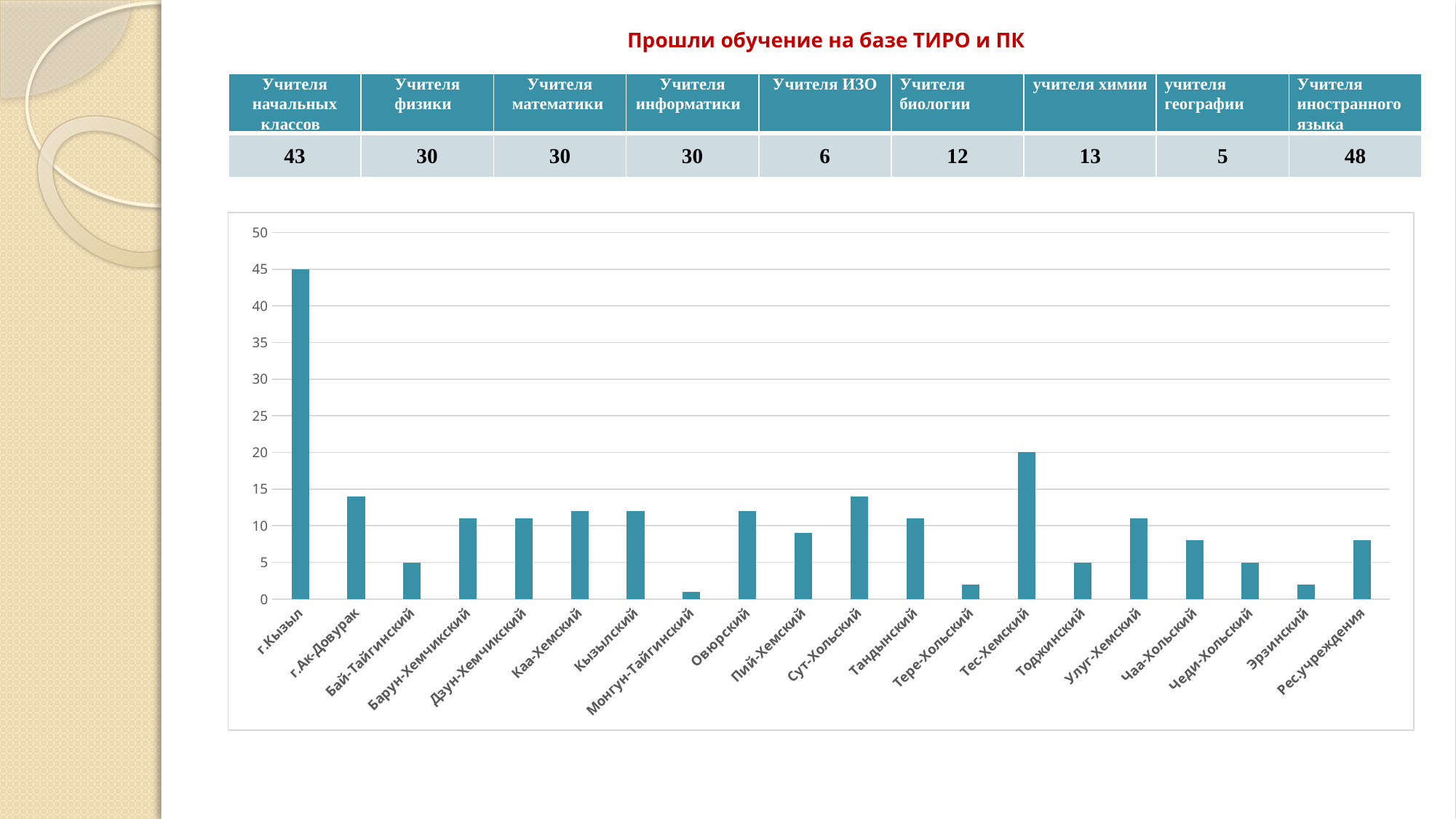
Is the value for г.Ак-Довурак greater or less than 10? greater Which is larger, the value for Тес-Хемский or the value for Сут-Хольский? Тес-Хемский Which category has the highest bar in the chart? г.Кызыл What kind of chart is shown on the slide? bar chart What is the value for Бай-Тайгинский in the chart? 5 What is the value for Тес-Хемский in the chart? 20 Is the value for Монгун-Тайгинский greater or less than 5? less Which is larger, the value for г.Ак-Довурак or the value for Бай-Тайгинский? г.Ак-Довурак How many categories are plotted on the x axis of the bar chart? 20 What is the value for г.Кызыл in the chart? 45 What is the difference between the values for г.Кызыл and Тес-Хемский? 25 What is the highest value shown on the y axis of the chart? 50